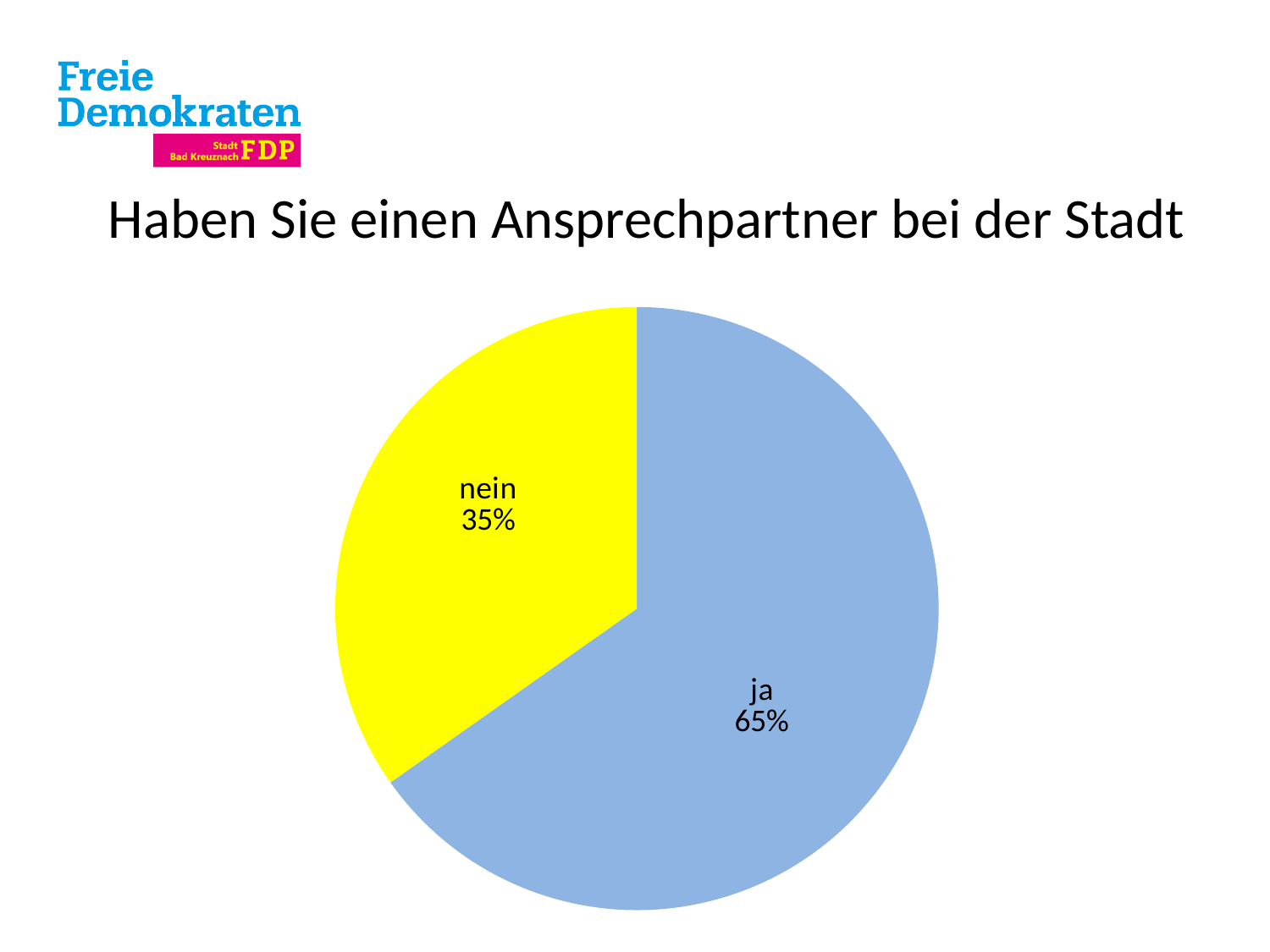
Which is larger, the "ja" slice or the "nein" slice? ja What percentage of respondents answered "ja"? 65% How many slices does the pie chart have? 2 What share of the pie does the "nein" slice represent? 35% What is the difference in percentage points between the "ja" and "nein" slices? 30 What kind of chart is shown on the slide? pie chart What is the title of the chart on the slide? Haben Sie einen Ansprechpartner bei der Stadt Which slice of the pie is the largest? ja Which slice of the pie is the smallest? nein What percentage of respondents answered "nein"? 35% What colour is the "nein" slice of the pie? yellow